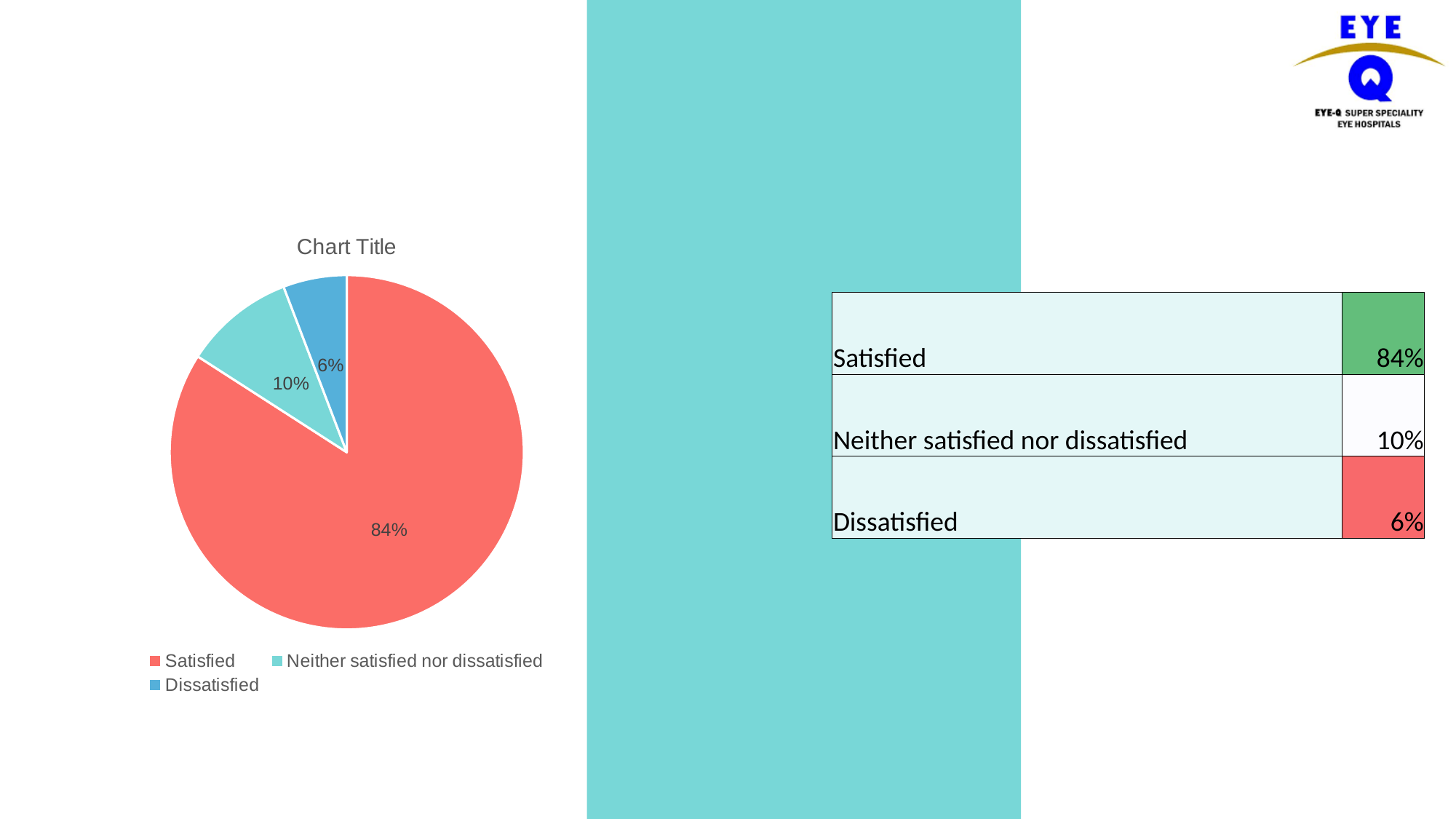
What type of chart is shown on the slide? pie chart What colour is the Satisfied slice in the pie chart? red What is the difference between the Satisfied and Dissatisfied values in the pie chart? 78% What is the difference between the Neither satisfied nor dissatisfied and Dissatisfied values in the pie chart? 4% What is the title of the pie chart? Chart Title What is the value for Dissatisfied in the pie chart? 6% What is the value for Satisfied in the pie chart? 84% Which category has the smallest slice in the pie chart? Dissatisfied Which is larger in the pie chart, Neither satisfied nor dissatisfied or Dissatisfied? Neither satisfied nor dissatisfied Which category has the largest slice in the pie chart? Satisfied How many categories does the pie chart show? 3 What is the value for Neither satisfied nor dissatisfied in the pie chart? 10%